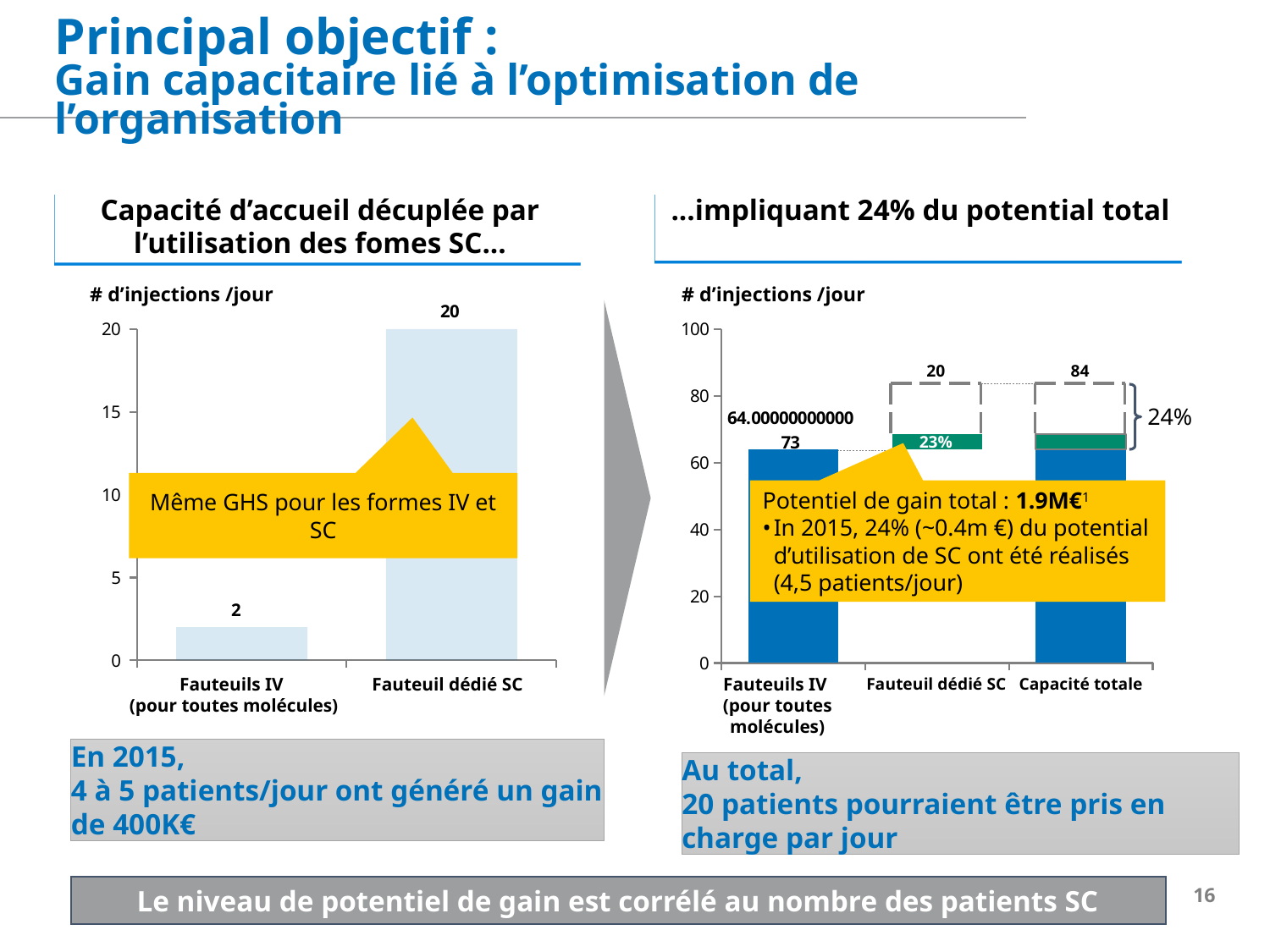
In the right chart (…impliquant 24% du potential total), what value is labelled above the dashed box for Capacité totale? 84 What type of chart is the left chart (Capacité d'accueil décuplée par l'utilisation des fomes SC…)? Bar chart In the left chart (Capacité d'accueil décuplée par l'utilisation des fomes SC…), which category has the lowest value? Fauteuils IV (pour toutes molécules) In the left chart (Capacité d'accueil décuplée par l'utilisation des fomes SC…), what is the value for Fauteuil dédié SC? 20 In the left chart (Capacité d'accueil décuplée par l'utilisation des fomes SC…), how many categories are shown on the x axis? 2 In the right chart (…impliquant 24% du potential total), what value is labelled above the dashed box for Fauteuil dédié SC? 20 What is the axis label shown above both charts? # d'injections /jour In the left chart (Capacité d'accueil décuplée par l'utilisation des fomes SC…), what is the value for Fauteuils IV (pour toutes molécules)? 2 In the left chart (Capacité d'accueil décuplée par l'utilisation des fomes SC…), which category has the highest value? Fauteuil dédié SC In the right chart (…impliquant 24% du potential total), how many categories are shown on the x axis? 3 In the right chart (…impliquant 24% du potential total), what is the highest value shown on the y axis? 100 In the left chart (Capacité d'accueil décuplée par l'utilisation des fomes SC…), what is the difference between Fauteuil dédié SC and Fauteuils IV? 18